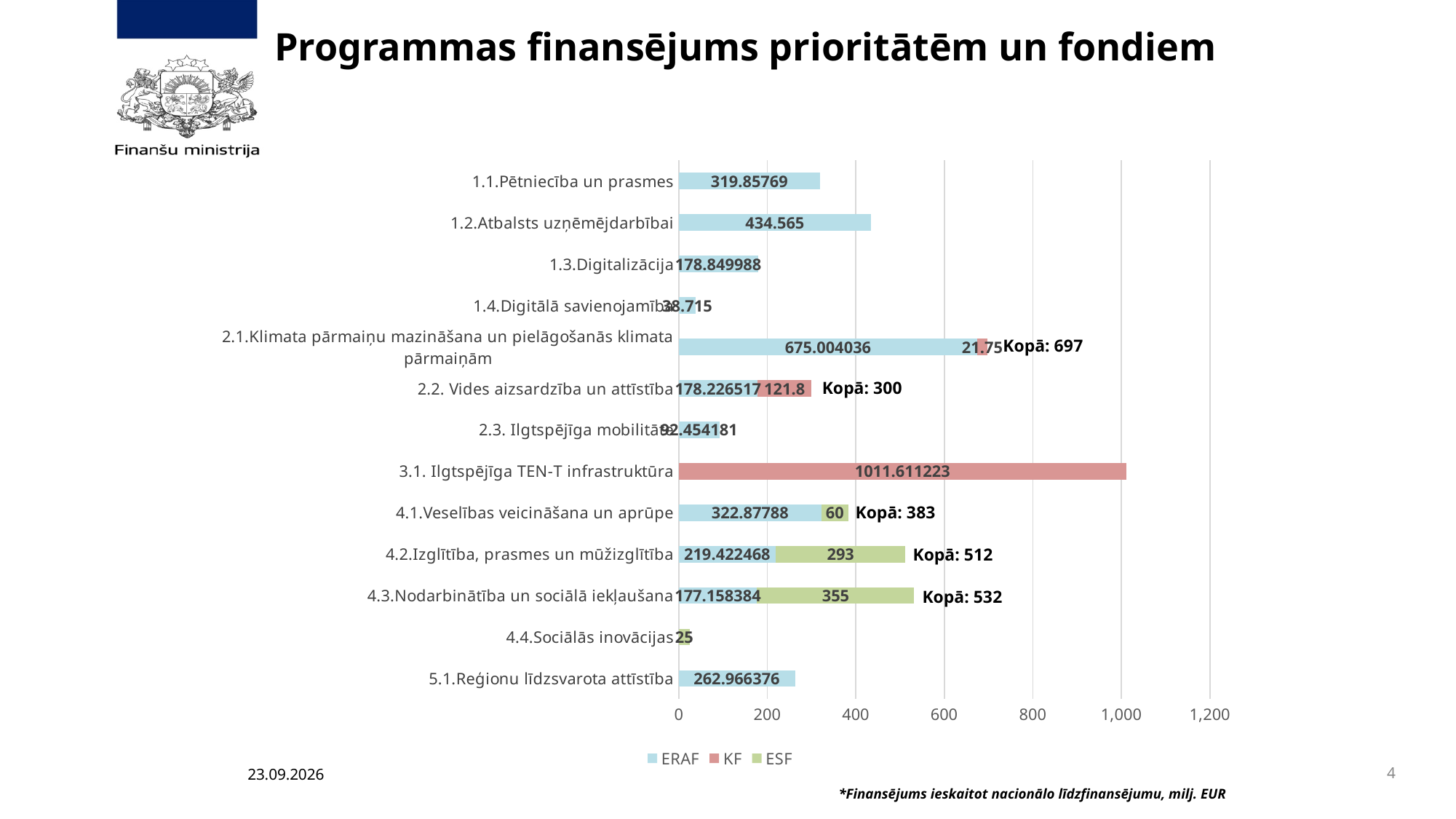
Which series is shown in red in the legend? KF What is the ERAF value for 5.1.Reģionu līdzsvarota attīstība? 262.966376 What kind of chart is shown on the slide? bar chart What is the difference between the ESF values for 4.3.Nodarbinātība un sociālā iekļaušana and 4.2.Izglītība, prasmes un mūžizglītība? 62 What is the total (Kopā) shown for 4.2.Izglītība, prasmes un mūžizglītība? 512 How many series does the legend list? 3 Which is larger: the ERAF value for 1.1.Pētniecība un prasmes or the ERAF value for 4.1.Veselības veicināšana un aprūpe? 4.1.Veselības veicināšana un aprūpe What is the KF value for 3.1. Ilgtspējīga TEN-T infrastruktūra? 1011.611223 How many categories (priorities) are plotted on the chart? 13 Which category has the longest bar overall? 3.1. Ilgtspējīga TEN-T infrastruktūra What is the ERAF value for 1.2.Atbalsts uzņēmējdarbībai? 434.565 What is the ESF value for 4.3.Nodarbinātība un sociālā iekļaušana? 355